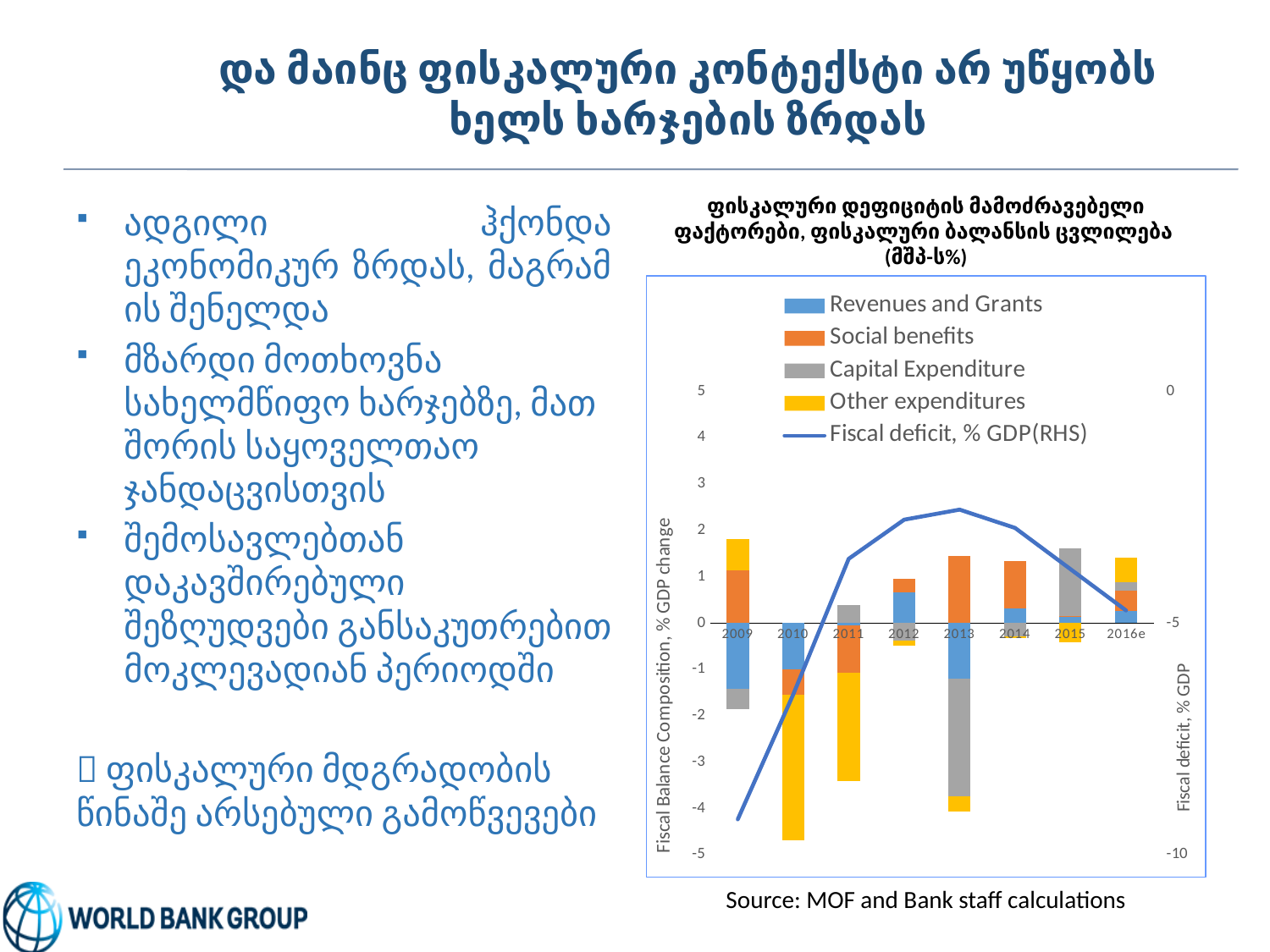
Is the Revenues and Grants value for 2009 greater or less than 0? less What is the title of the left vertical axis of the chart? Fiscal Balance Composition, % GDP change Which year has the larger Other expenditures bar segment, 2010 or 2011? 2010 Which series in the chart is plotted as a line? Fiscal deficit, % GDP(RHS) What kind of chart is shown on the slide? A stacked bar chart combined with a line Is the Fiscal deficit value for 2013 on the right-hand axis greater or less than -5? greater In which year is the Capital Expenditure bar segment the largest? 2013 Does the Fiscal deficit line rise or fall from 2013 to 2016e? Falls How many series does the chart legend list? 5 How many years are shown along the x axis of the chart? 8 Is the Fiscal deficit value for 2009 on the right-hand axis greater or less than -5? less Does the Fiscal deficit line rise or fall from 2009 to 2013? Rises